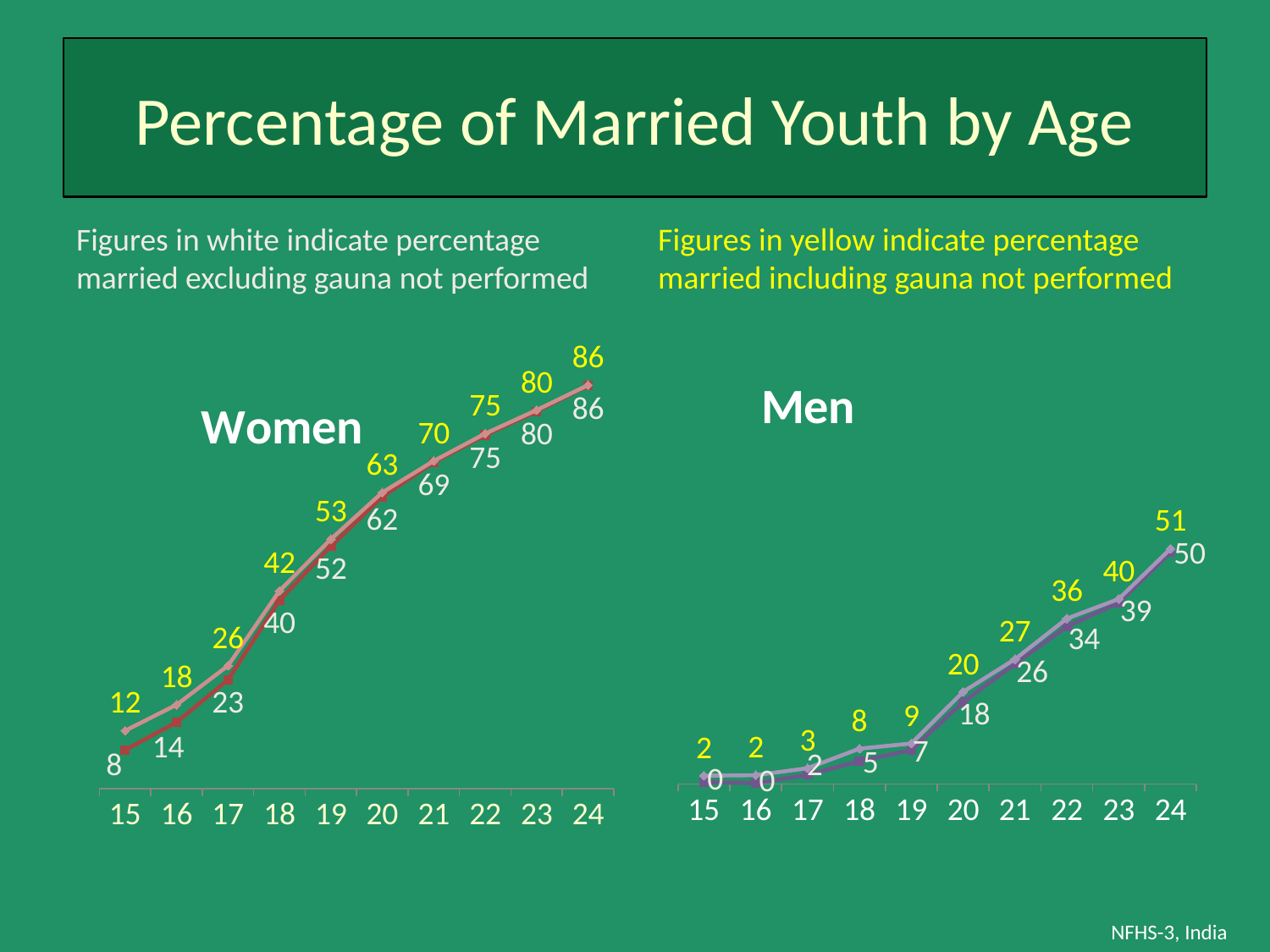
In the Men chart, what is the yellow figure (percentage married including gauna not performed) at age 24? 51 In the Women chart, what is the yellow figure (percentage married including gauna not performed) at age 18? 42 In the Women chart, at which age is the white figure (excluding gauna not performed) lowest? 15 In the Men chart, do the white figures rise or fall as age increases from 15 to 24? Rise In the Men chart, what is the white figure (percentage married excluding gauna not performed) at age 21? 26 How many age categories are shown on the x axis of the Men chart? 10 In the Women chart, what is the white figure (percentage married excluding gauna not performed) at age 20? 62 In the Men chart, at which age is the yellow figure (including gauna not performed) highest? 24 Which is larger: the white figure at age 22 in the Women chart or the white figure at age 22 in the Men chart? Women (75) In the Men chart, what is the difference between the white figures at age 24 and age 20? 32 In the Women chart, what is the difference between the yellow and white figures at age 17? 3 What type of chart is used for the Women data? Line chart